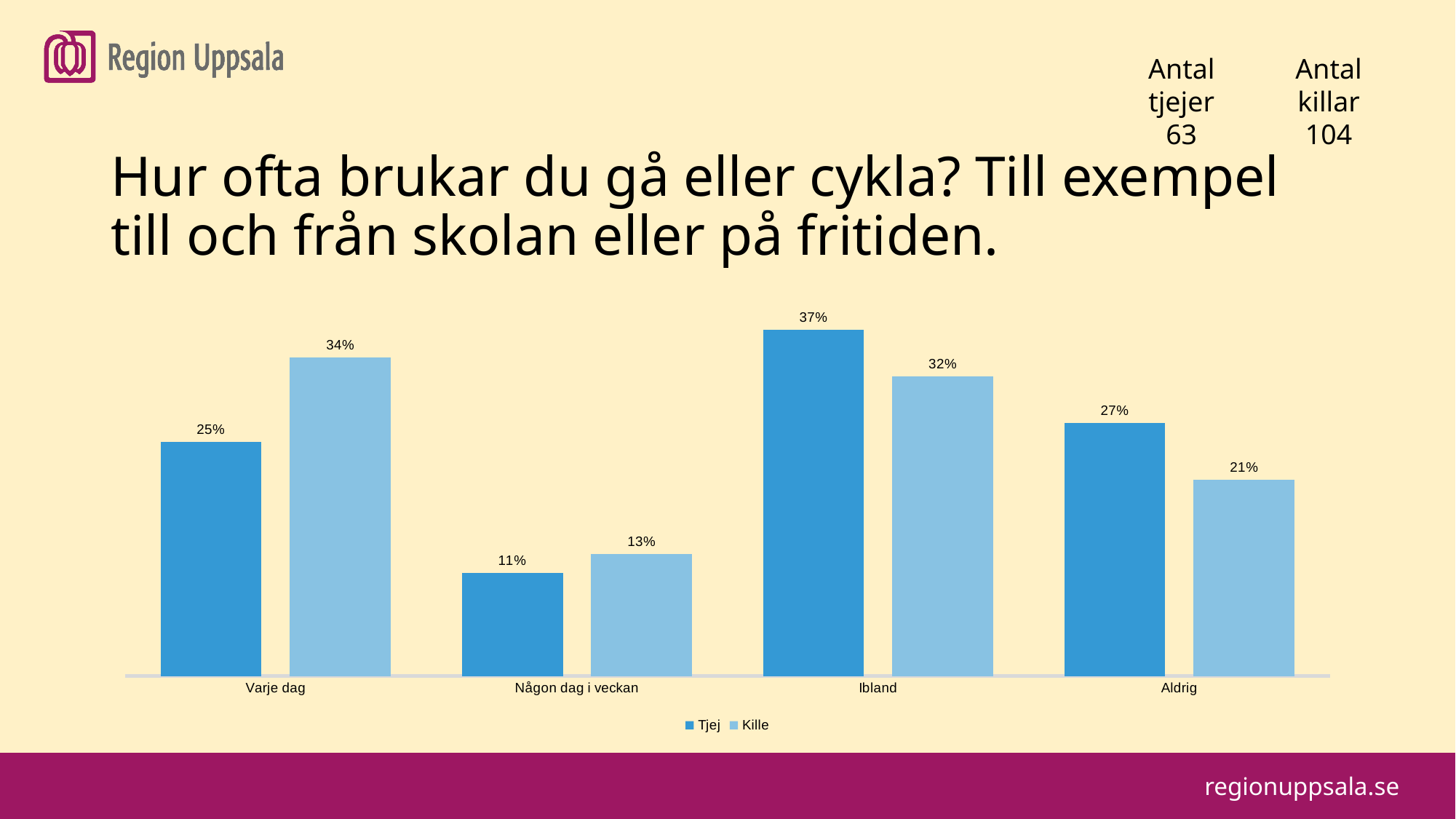
How many categories are shown on the x axis? 4 Which category has the highest value for Tjej? Ibland Which is larger in the Aldrig category, the Tjej value or the Kille value? Tjej What is the difference between the Kille and Tjej values in the Varje dag category? 9% What are the two series named in the legend? Tjej and Kille What is the value for Kille in the Ibland category? 32% What is the difference between the Tjej and Kille values in the Ibland category? 5% What kind of chart is shown on the slide? Bar chart What is the value for Kille in the Aldrig category? 21% What is the value for Tjej in the Varje dag category? 25% Which category has the lowest value for Kille? Någon dag i veckan How many series does the legend list? 2